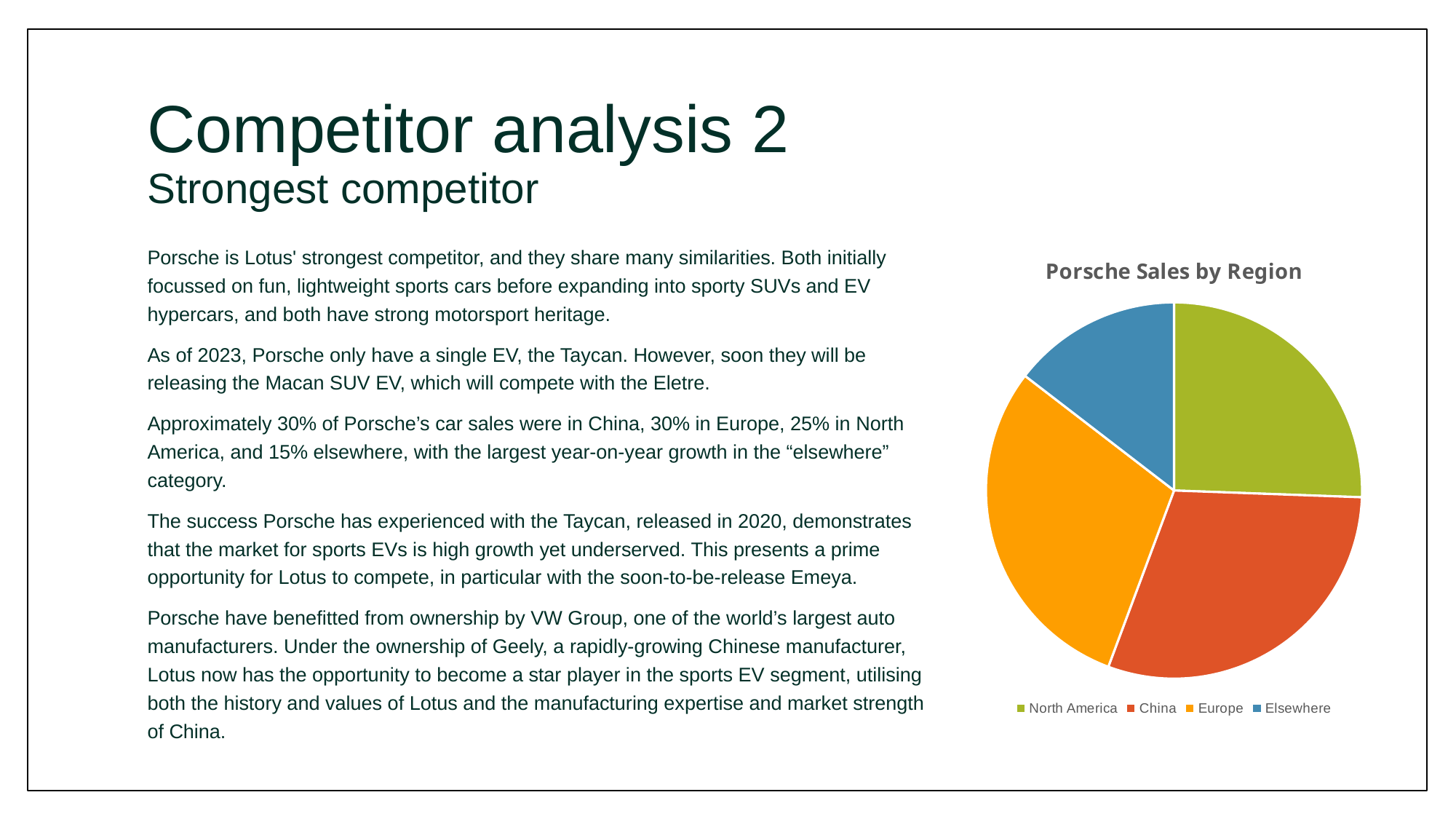
How many entries does the chart legend list? 4 Which slice is larger in the pie chart, Europe or Elsewhere? Europe Which slice is larger in the pie chart, China or Elsewhere? China Which region is represented by the blue slice in the pie chart? Elsewhere How many regions (slices) does the pie chart show? 4 What is the title of the chart? Porsche Sales by Region What kind of chart is shown on the slide? pie chart Which slice is larger in the pie chart, North America or Elsewhere? North America Which region has the smallest slice in the pie chart? Elsewhere